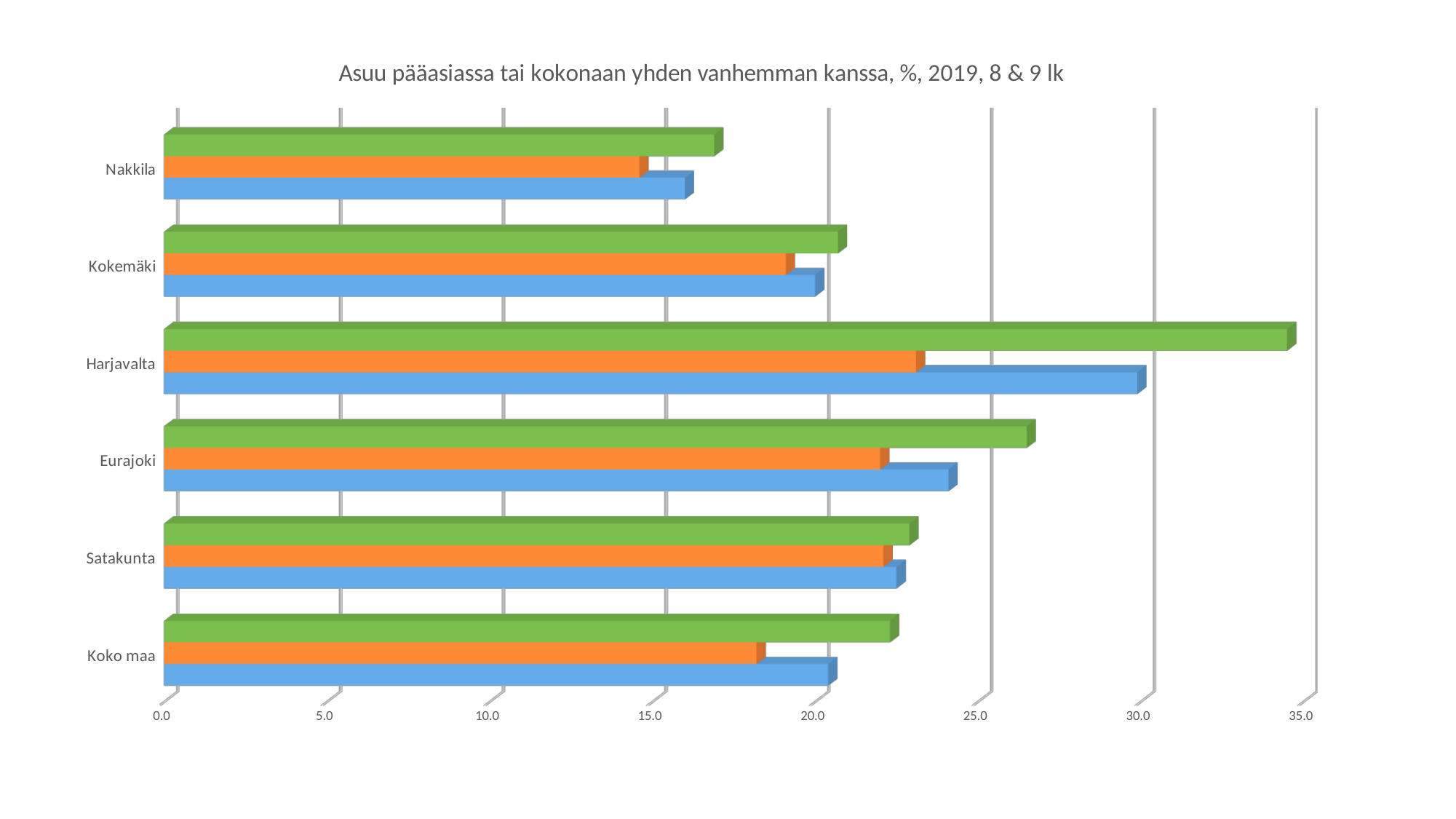
What is the title of the chart? Asuu pääasiassa tai kokonaan yhden vanhemman kanssa, %, 2019, 8 & 9 lk Which category has the shortest green bar? Nakkila Is the green bar for Eurajoki greater or less than 25.0? greater Which is longer, the green bar for Harjavalta or the green bar for Eurajoki? Harjavalta Is the green bar for Harjavalta greater or less than 30.0? greater Is the orange bar for Koko maa greater or less than 20.0? less Which is longer, the blue bar for Nakkila or the blue bar for Kokemäki? Kokemäki Which category has the longest green bar? Harjavalta What kind of chart is shown on the slide? bar chart How many categories are shown on the vertical axis of the chart? 6